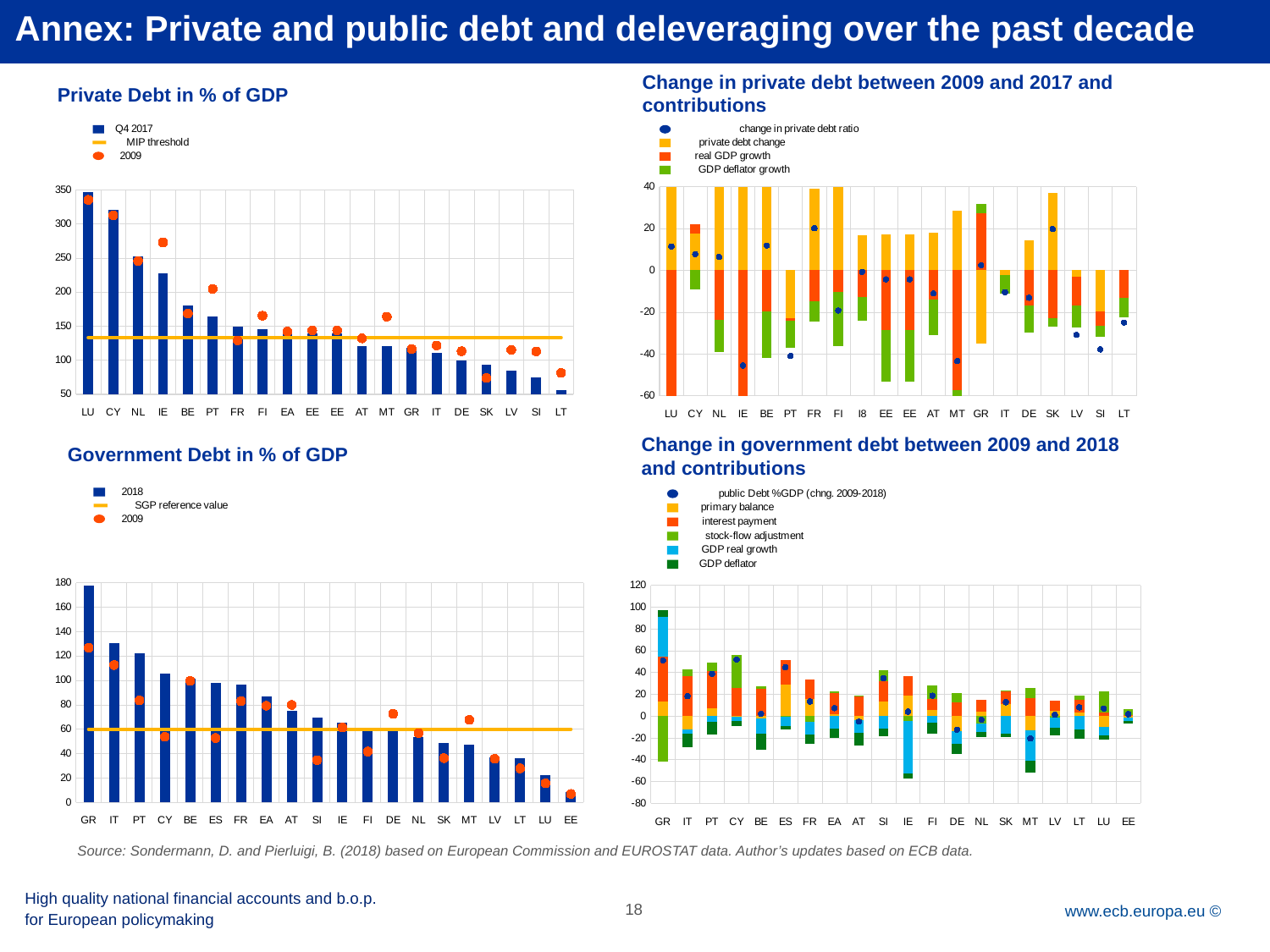
In the 'Private Debt in % of GDP' chart, which country has the highest Q4 2017 bar? LU In the 'Government Debt in % of GDP' chart, is the 2018 value for IT greater or less than 120? greater In the 'Private Debt in % of GDP' chart, which country has the lowest Q4 2017 bar? LT In the 'Private Debt in % of GDP' chart, what kind of chart is used for the Q4 2017 values? bar chart In the 'Private Debt in % of GDP' chart, is the Q4 2017 value for CY greater or less than 300? greater In the 'Government Debt in % of GDP' chart, how many countries are shown on the x axis? 20 In the 'Government Debt in % of GDP' chart, which country has the lowest 2018 bar? EE In the 'Private Debt in % of GDP' chart, how many entries does the legend list? 3 In the 'Government Debt in % of GDP' chart, which country has the highest 2018 bar? GR In the 'Change in government debt between 2009 and 2018 and contributions' chart, how many entries does the legend list? 6 How many charts are shown on the slide? 4 In the 'Change in private debt between 2009 and 2017 and contributions' chart, how many entries does the legend list? 4